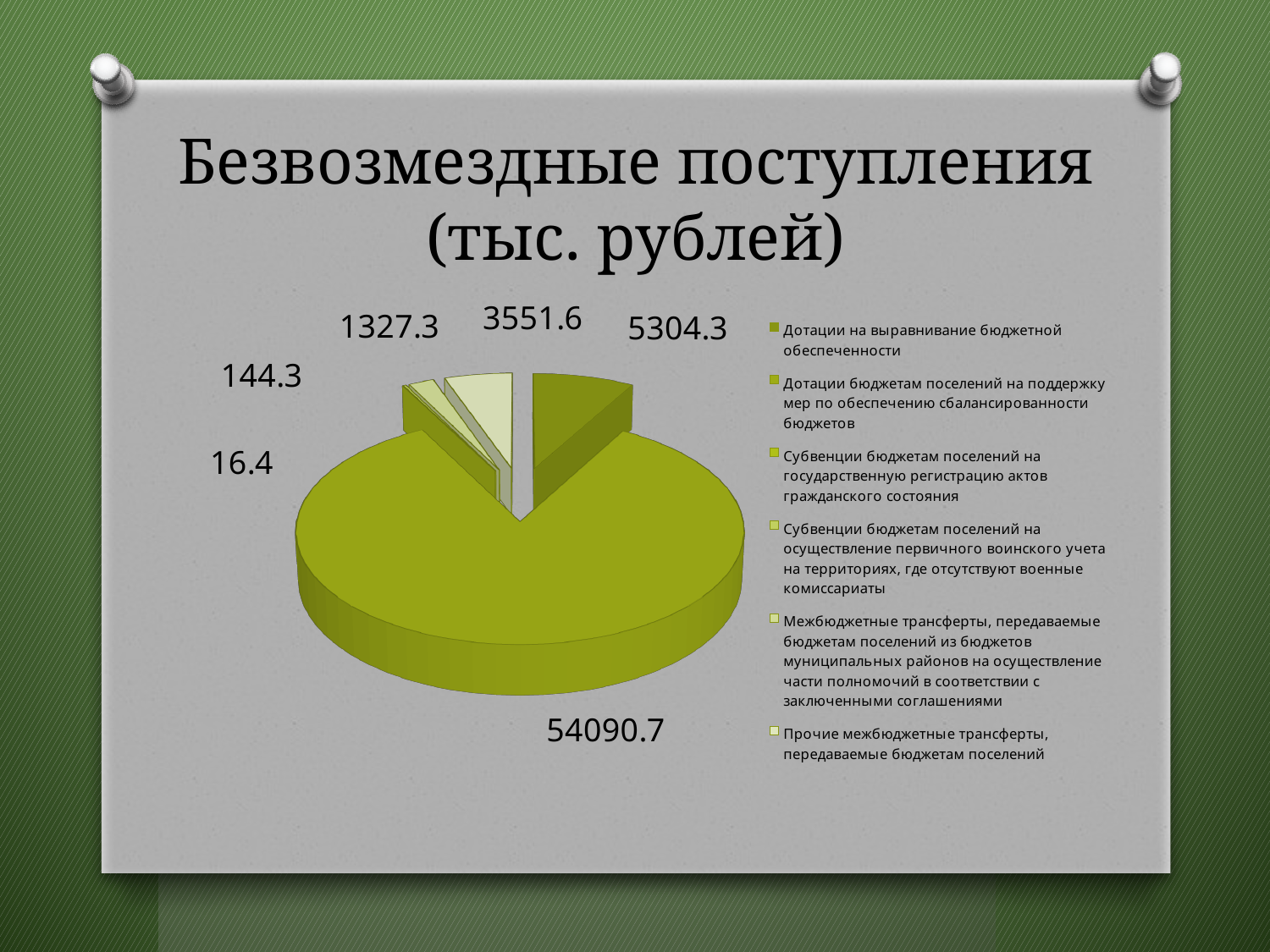
What is the difference between the largest slice (54090.7) and the second largest slice (5304.3)? 48786.4 How many slices does the pie chart have? 6 Is the largest slice of the pie chart greater or less than 50000? greater Which is larger, the slice labelled 144.3 or the slice labelled 16.4? 144.3 What is the largest value shown on the pie chart? 54090.7 What is the title of the chart on the slide? Безвозмездные поступления (тыс. рублей) What is the first entry listed in the legend of the pie chart? Дотации на выравнивание бюджетной обеспеченности What is the difference between the slices labelled 3551.6 and 1327.3? 2224.3 What is the smallest value shown on the pie chart? 16.4 What type of chart is shown on the slide? pie chart How many entries does the legend of the pie chart list? 6 What is the total of all the values shown on the pie chart? 64434.6